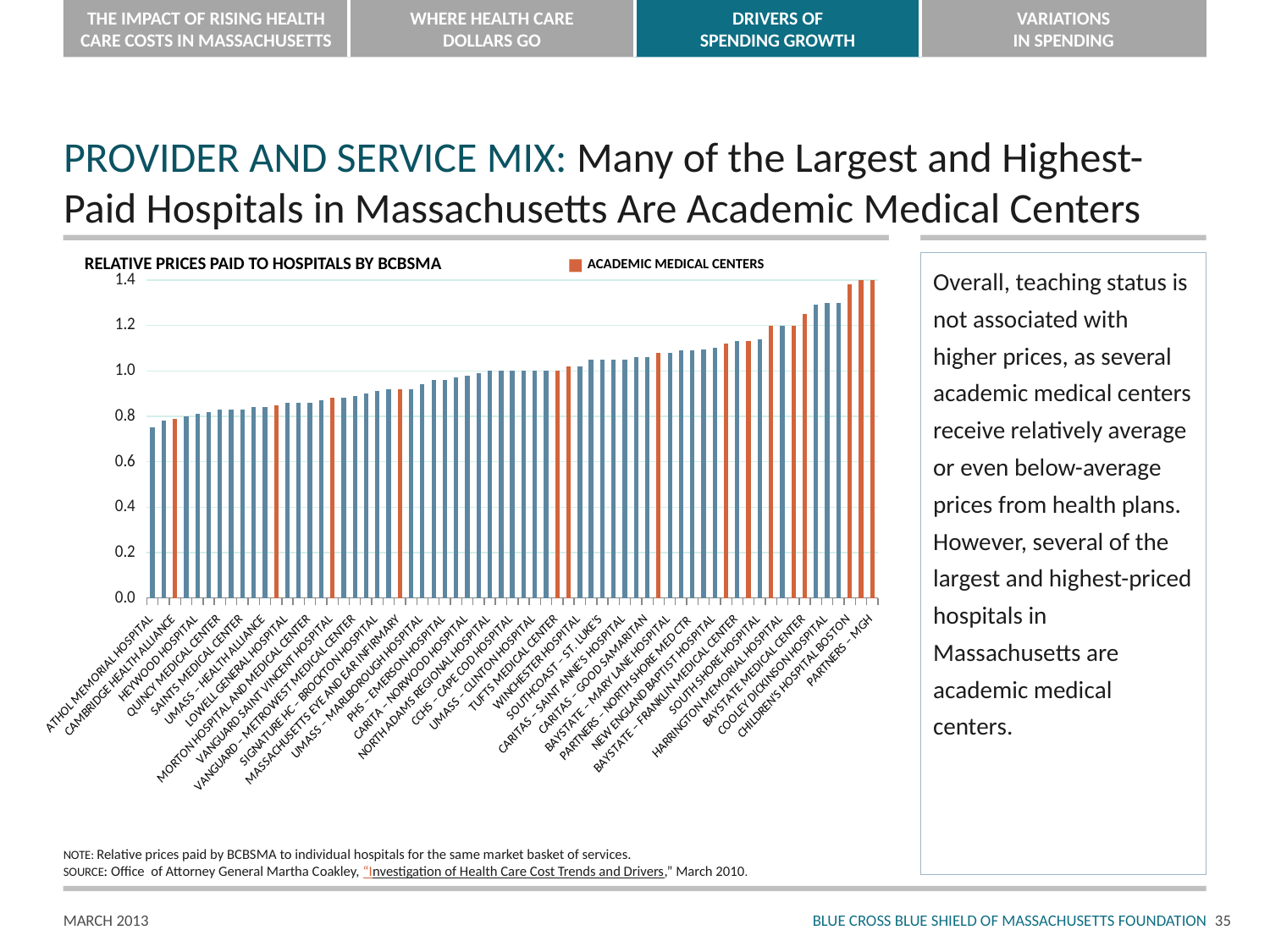
How many entries does the chart legend list? 1 Is the relative price for Athol Memorial Hospital greater or less than 0.8? less What does the orange colour in the chart indicate? Academic Medical Centers Which hospital has the highest relative price in the chart? Partners – MGH Is the relative price for Partners – MGH greater or less than 1.2? greater Which hospital has the lowest relative price in the chart? Athol Memorial Hospital Is the relative price for Children's Hospital Boston greater or less than 1.2? greater What is the highest value shown on the y axis of the chart? 1.4 Which has a higher relative price, Partners – MGH or Athol Memorial Hospital? Partners – MGH What is the title of the chart? Relative Prices Paid to Hospitals by BCBSMA What kind of chart is shown on the slide? Bar chart Do the relative prices rise or fall moving from left to right along the x axis? Rise